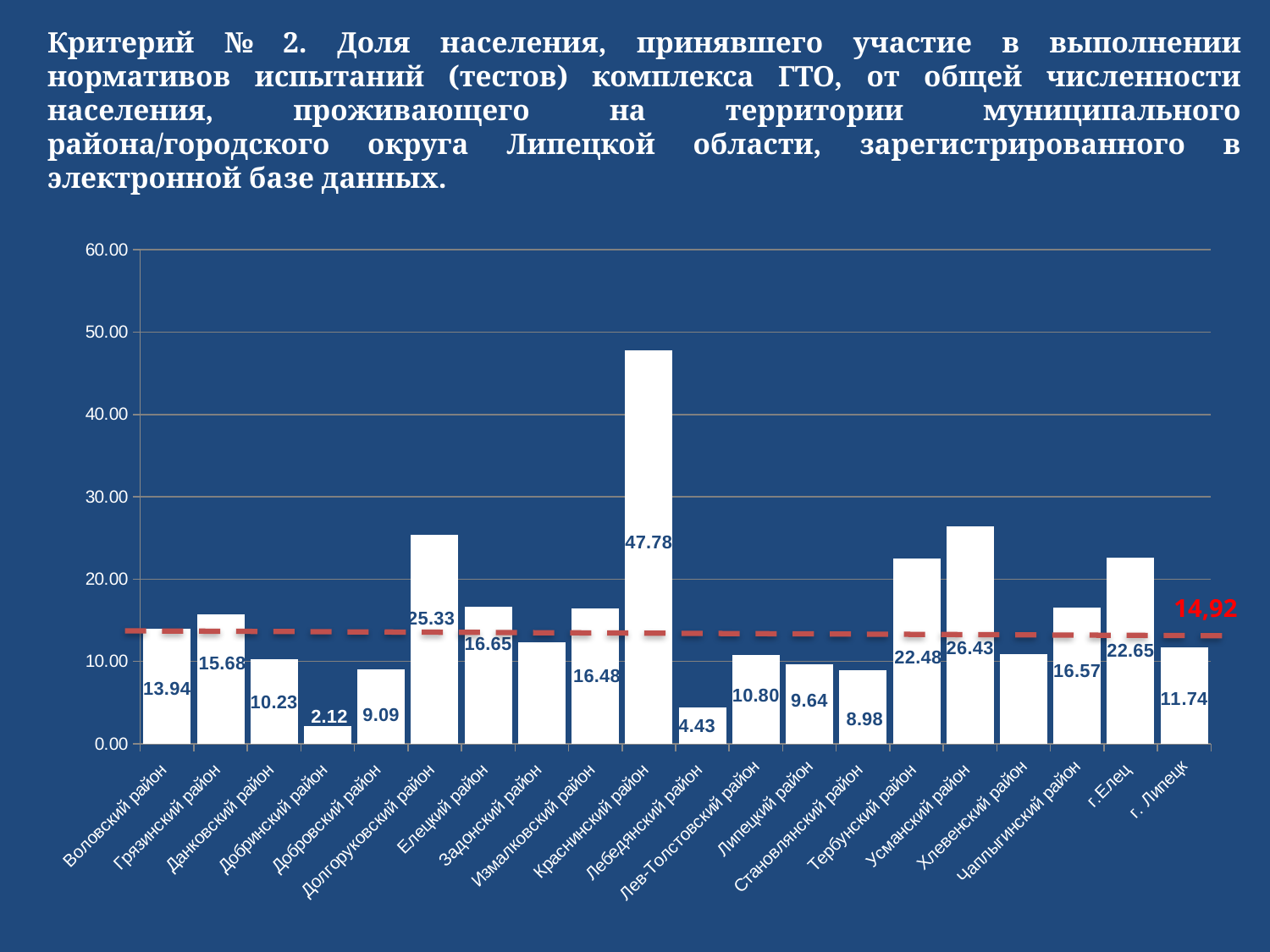
What is the value for Краснинский район? 47.78 What is the value for Усманский район? 26.43 How many categories are shown on the x axis? 20 What is the value for Добринский район? 2.12 Which category has the highest value? Краснинский район Which is larger, the value for Долгоруковский район or the value for г.Елец? Долгоруковский район Is the value for Задонский район greater or less than 10.00? greater What kind of chart is shown on the slide? bar chart What is the difference between the values for Усманский район and Тербунский район? 3.95 What is the value for г. Липецк? 11.74 What value is labelled on the red dashed horizontal line? 14,92 Which category has the lowest value? Добринский район